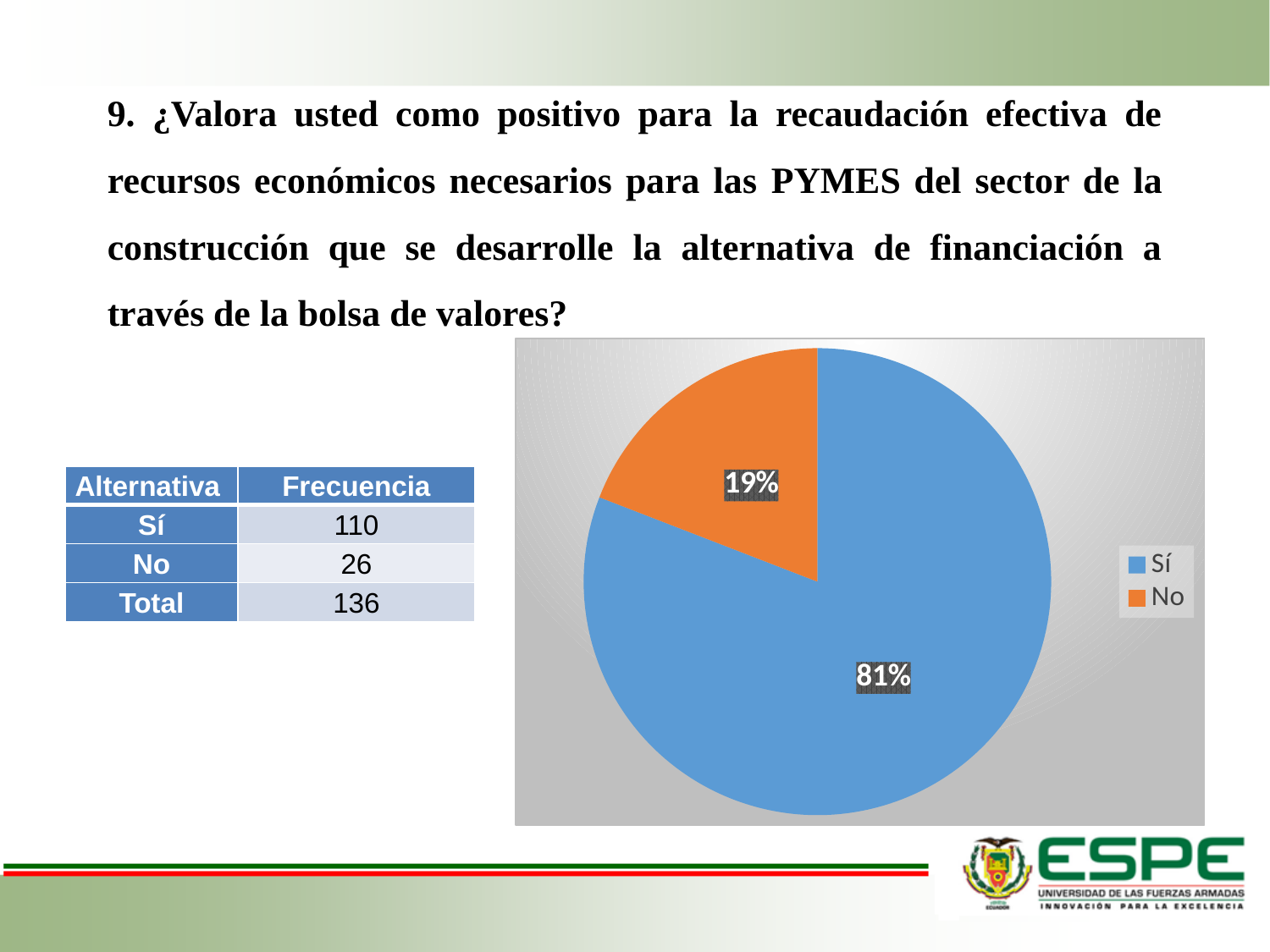
What share of the pie does the "No" slice represent? 19% How many slices does the pie chart have? 2 What colour is the "No" slice in the pie chart? orange What is the difference in percentage points between the "Sí" and "No" slices? 62% Which is larger in the pie chart, the "Sí" slice or the "No" slice? Sí Which slice of the pie is the largest? Sí What share of the pie does the "Sí" slice represent? 81% How many entries does the legend of the pie chart list? 2 What colour is the "Sí" slice in the pie chart? blue What kind of chart is shown on the slide? pie chart Which slice of the pie is the smallest? No